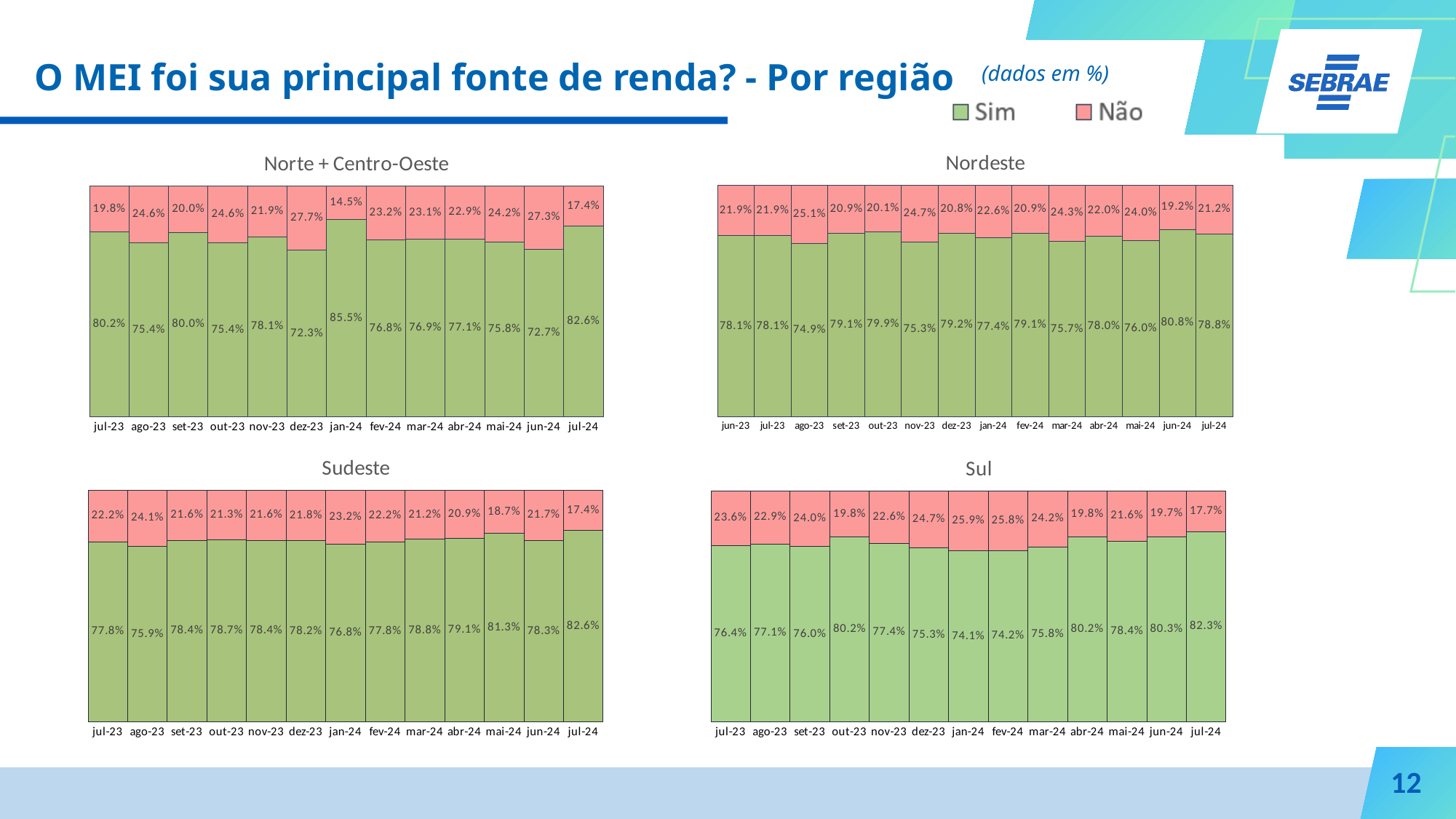
In the Nordeste chart, what is the difference between the Sim values for jun-24 and ago-23? 5.9 percentage points How many months are shown on the x axis of the Nordeste chart? 14 In the Sudeste chart, which is larger: the Sim value for mai-24 or the Sim value for jan-24? mai-24 In the Sul chart, which month has the highest value for Não? jan-24 In the Sudeste chart, which month has the highest value for Sim? jul-24 In the Norte + Centro-Oeste chart, what is the value for Sim in jan-24? 85.5% In the Nordeste chart, what is the value for Não in ago-23? 25.1% In the Sul chart, what is the total of the stacked bar for out-23? 100.0% In the Sul chart, what is the value for Sim in jul-24? 82.3% What kind of chart is the Sul chart? Stacked bar chart How many series does the legend list? 2 In the Norte + Centro-Oeste chart, which month has the lowest value for Sim? dez-23